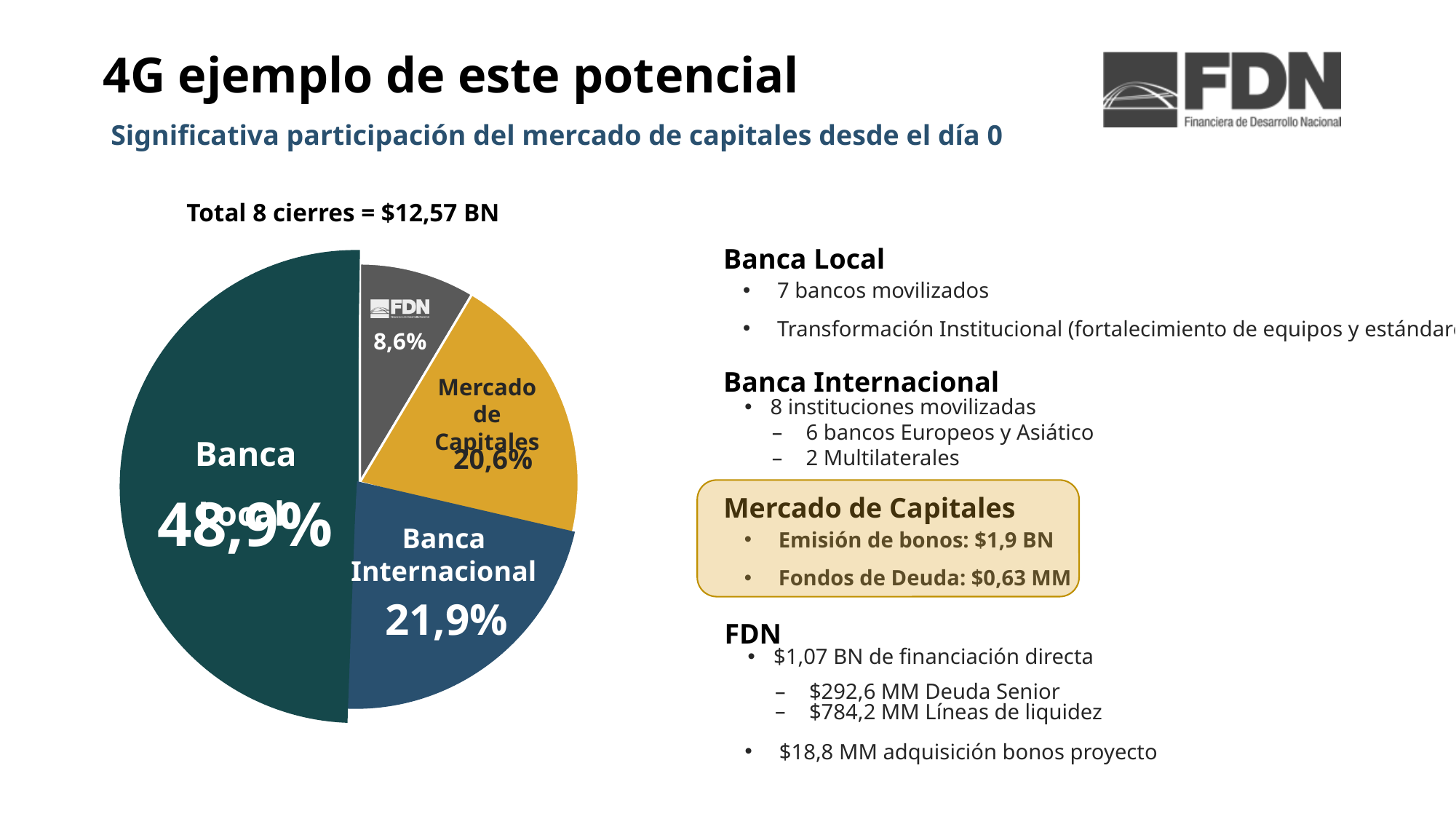
What kind of chart is shown on the slide? pie chart What is the difference in percentage points between Mercado de Capitales and FDN? 12,0 What is the title shown above the pie chart? Total 8 cierres = $12,57 BN What share of the pie does the FDN slice hold? 8,6% Which slice of the pie is the largest? Banca Local Which is larger, the Banca Internacional slice or the FDN slice? Banca Internacional Which slice of the pie is the smallest? FDN What is the difference in percentage points between Banca Local and Banca Internacional? 27,0 How many slices does the pie chart have? 4 What share of the pie does Banca Local hold? 48,9% What share of the pie does Mercado de Capitales hold? 20,6%